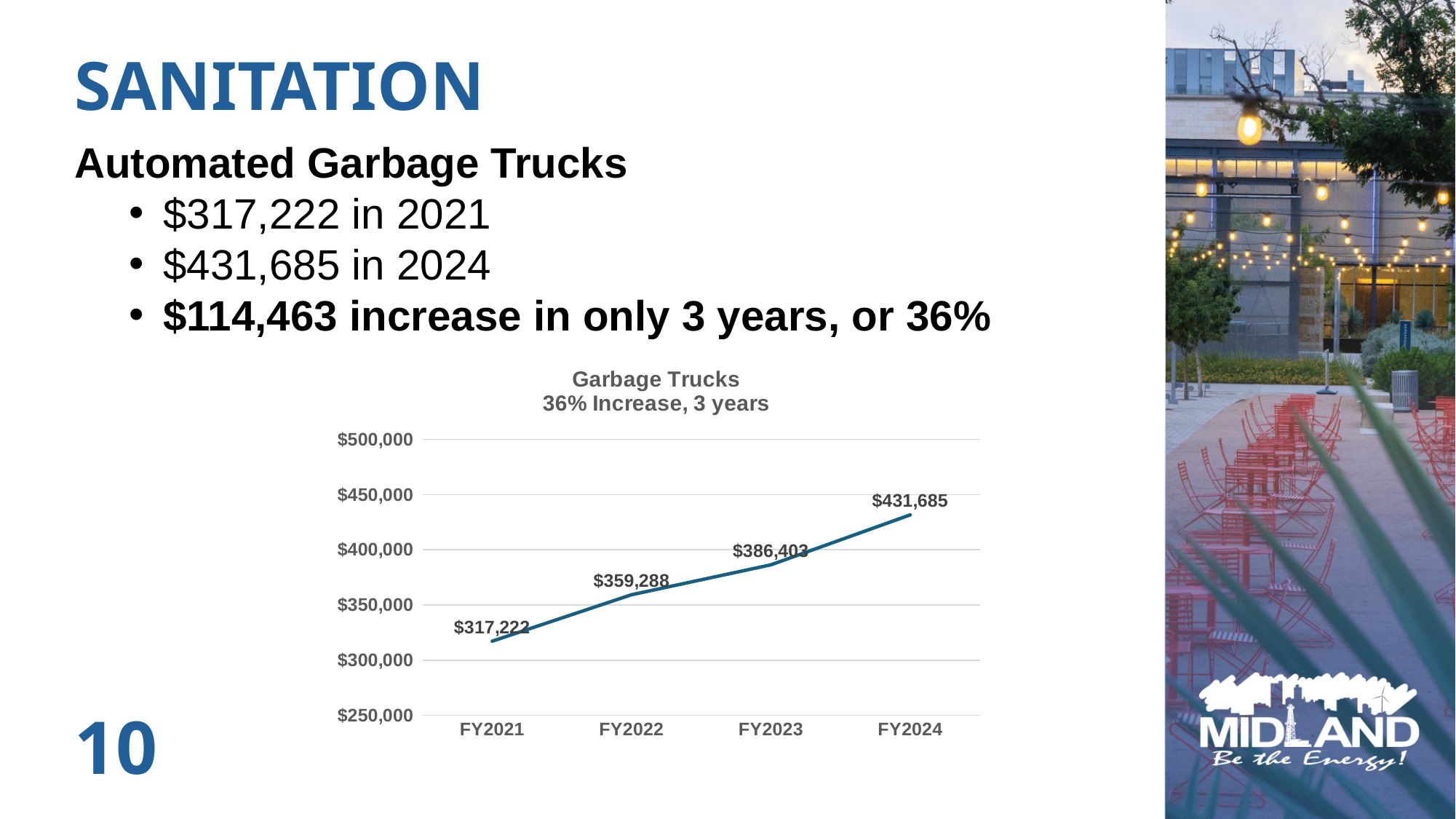
What is the difference between the FY2024 and FY2021 values in the Garbage Trucks chart? $114,463 Which is larger in the Garbage Trucks chart, the FY2022 value or the FY2023 value? FY2023 What is the difference between the FY2023 and FY2022 values in the Garbage Trucks chart? $27,115 What is the value for FY2022 in the Garbage Trucks chart? $359,288 Which fiscal year has the lowest value in the Garbage Trucks chart? FY2021 Which fiscal year has the highest value in the Garbage Trucks chart? FY2024 Do the values in the Garbage Trucks chart rise or fall from FY2021 to FY2024? Rise What kind of chart is the Garbage Trucks chart? Line chart What is the value for FY2024 in the Garbage Trucks chart? $431,685 What is the value for FY2023 in the Garbage Trucks chart? $386,403 How many fiscal years are plotted in the Garbage Trucks chart? 4 What is the value for FY2021 in the Garbage Trucks chart? $317,222